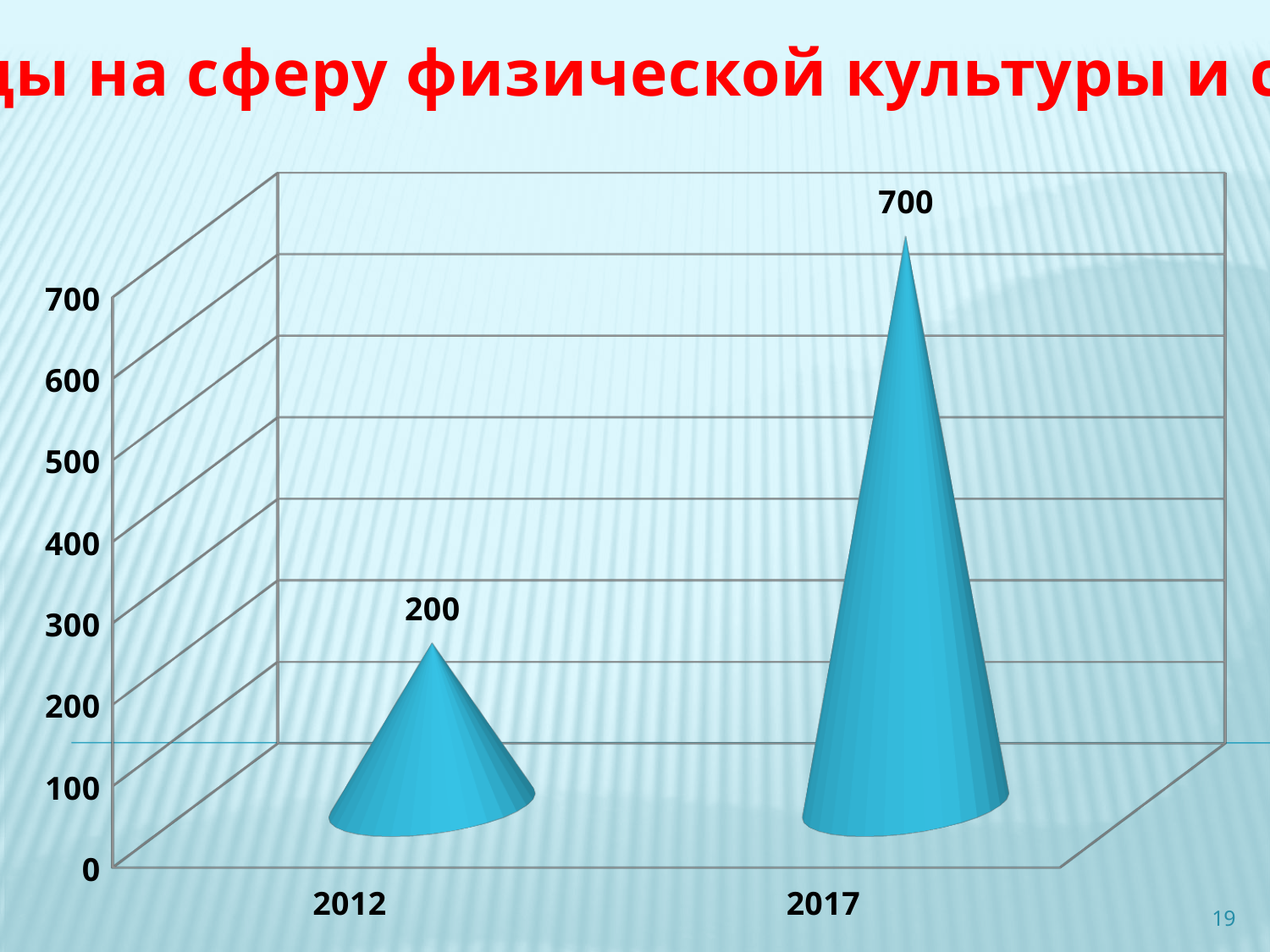
Which year has the lowest value? 2012 Which is larger, the value for 2012 or the value for 2017? 2017 Which year has the highest value? 2017 What is the difference between the values for 2017 and 2012? 500 Is the value for 2012 greater or less than 300? less What is the value for 2017? 700 Is the value for 2017 greater or less than 500? greater What is the highest tick value shown on the vertical axis? 700 What is the value for 2012? 200 How many categories are shown on the x axis? 2 What kind of chart is shown on the slide? bar chart Do the values rise or fall from 2012 to 2017? rise